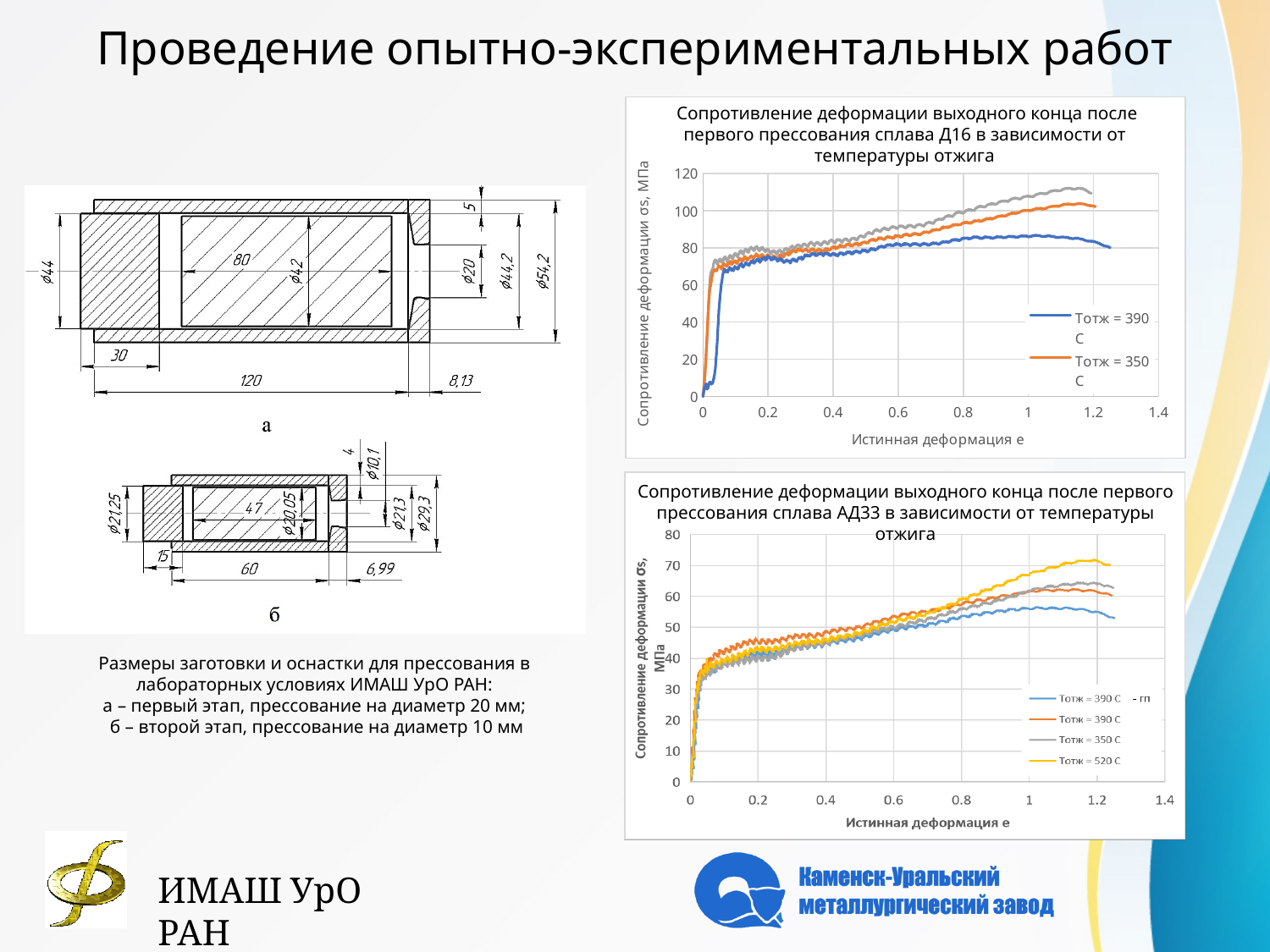
What is the maximum value shown on the y axis of the top chart (Д16 alloy)? 120 What is the label of the x axis of the bottom chart (АД33 alloy)? Истинная деформация e How many series does the legend of the top chart (Д16 alloy) list? 2 In the bottom chart (АД33 alloy), is the value of the Тотж = 520 С series at true strain 1.2 greater or less than 60? greater In the top chart (Д16 alloy), do the values of the Тотж = 350 С series generally rise or fall as true strain increases from 0.2 to 1.2? rise In the bottom chart (АД33 alloy), is the value of the Тотж = 390 С - гп series at true strain 1.0 greater or less than 60? less In the top chart (Д16 alloy), is the value of the Тотж = 350 С series at true strain 1.2 greater or less than 100? greater In the bottom chart (АД33 alloy), at true strain 1.2, which is larger: the Тотж = 520 С series or the Тотж = 390 С - гп series? Тотж = 520 С In the bottom chart (АД33 alloy), which series has the highest value at true strain 1.2? Тотж = 520 С What kind of chart is the top chart (Д16 alloy)? line chart How many series does the legend of the bottom chart (АД33 alloy) list? 4